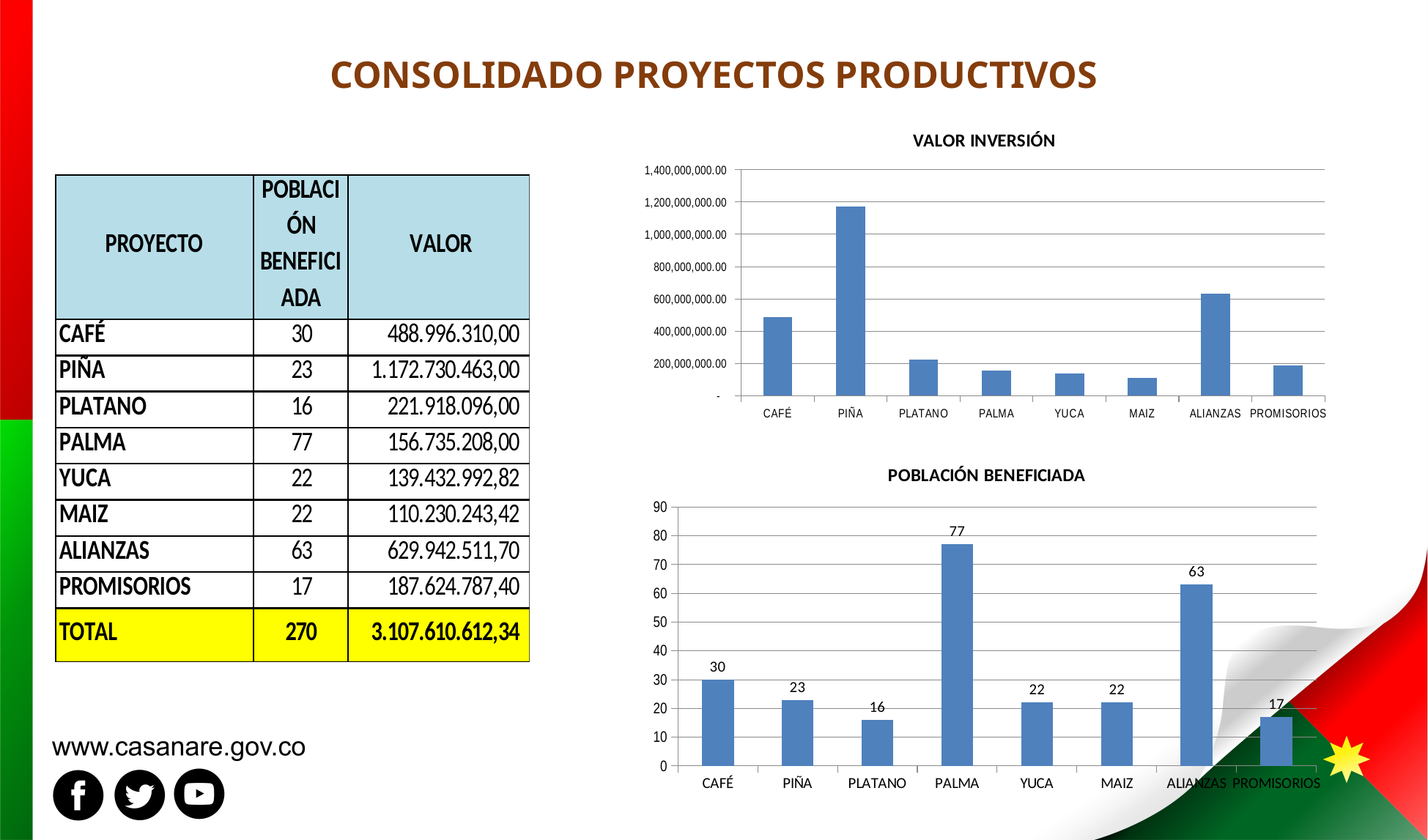
In the VALOR INVERSIÓN chart, is the value for ALIANZAS greater or less than 600,000,000.00? greater In the VALOR INVERSIÓN chart, is the value for PLATANO greater or less than 400,000,000.00? less How many categories are shown in the POBLACIÓN BENEFICIADA chart? 8 In the POBLACIÓN BENEFICIADA chart, which category has the lowest value? PLATANO In the POBLACIÓN BENEFICIADA chart, what is the difference between the values for ALIANZAS and CAFÉ? 33 In the POBLACIÓN BENEFICIADA chart, what is the value for PALMA? 77 In the VALOR INVERSIÓN chart, which category has the lowest value? MAIZ In the POBLACIÓN BENEFICIADA chart, which category has the highest value? PALMA In the VALOR INVERSIÓN chart, which category has the highest value? PIÑA What kind of chart is the VALOR INVERSIÓN chart? bar chart In the POBLACIÓN BENEFICIADA chart, what is the value for PLATANO? 16 In the POBLACIÓN BENEFICIADA chart, which is larger, the value for PIÑA or the value for PROMISORIOS? PIÑA